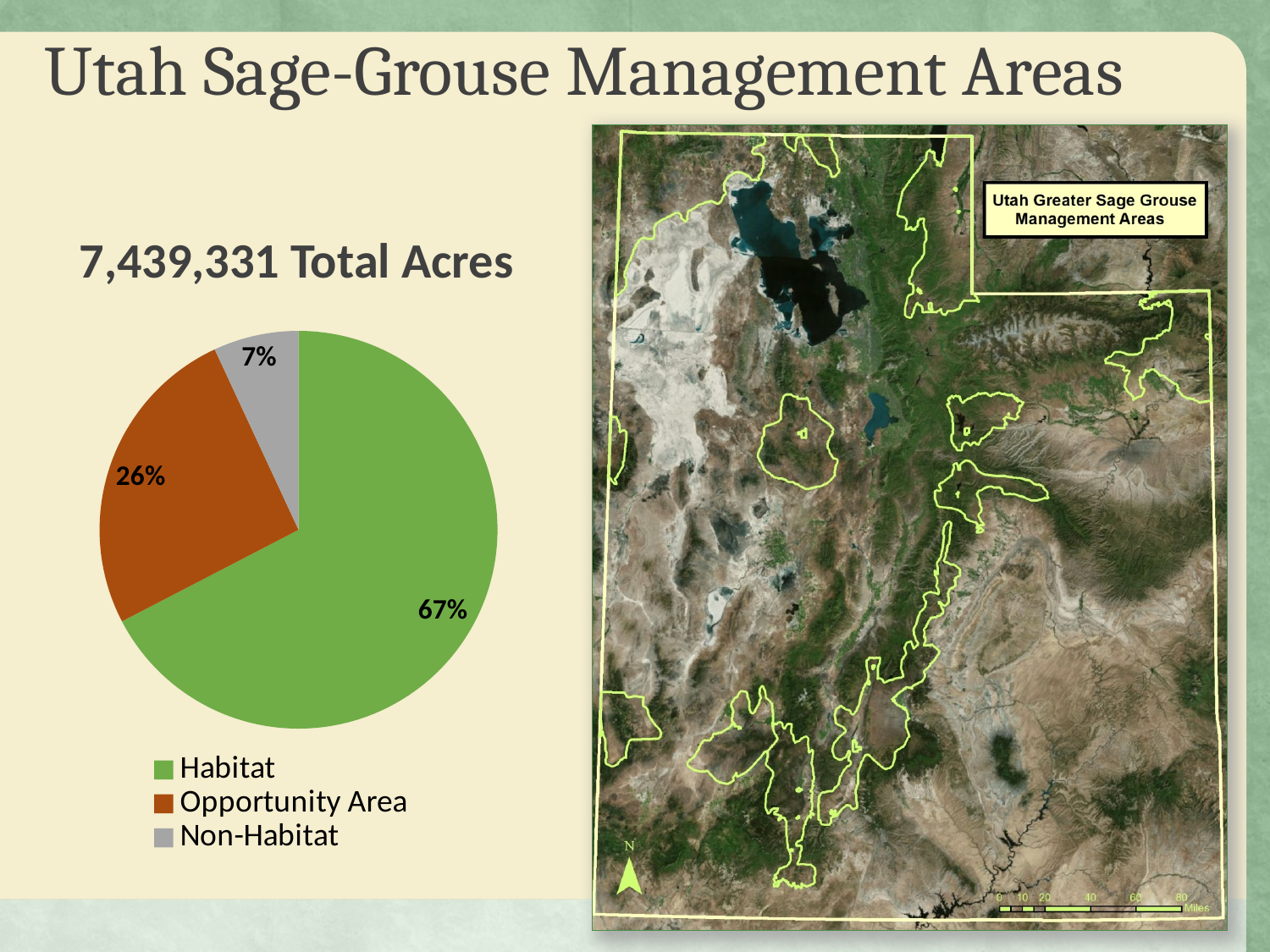
What type of chart is shown on the slide? pie chart What is the difference in percentage points between Opportunity Area and Non-Habitat? 19 Which category has the smallest share of the pie? Non-Habitat How many categories does the pie chart have? 3 Which is larger, the Opportunity Area slice or the Non-Habitat slice? Opportunity Area What is the difference in percentage points between Habitat and Opportunity Area? 41 What percentage of the pie is Habitat? 67% What is the chart's title? 7,439,331 Total Acres What colour is the Opportunity Area slice? orange-brown What percentage of the pie is Non-Habitat? 7% Which category has the largest share of the pie? Habitat What percentage of the pie is Opportunity Area? 26%